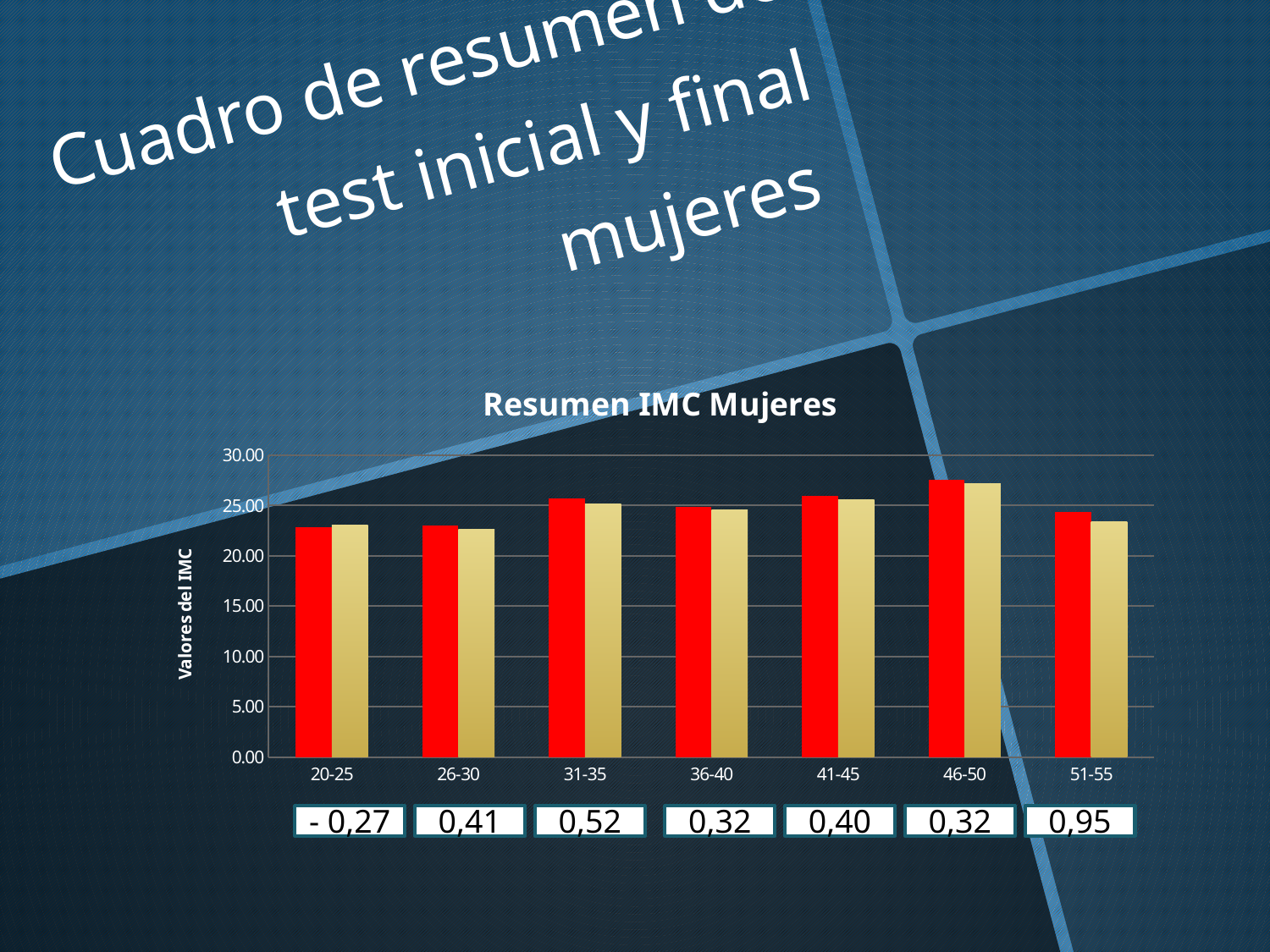
Is the red bar for the 46-50 age group greater or less than 25.00? greater What kind of chart is shown on the slide? bar chart How many bars are plotted for each age group in the chart? 2 Which red bar is taller, the one for 26-30 or the one for 46-50? 46-50 In the 51-55 age group, which bar is taller, the red one or the gold one? the red one How many age-group categories are shown on the x axis of the chart? 7 What is the title of the chart? Resumen IMC Mujeres Is the red bar for the 41-45 age group greater or less than 20.00? greater Is the gold bar for the 51-55 age group greater or less than 25.00? less What is the label on the vertical axis of the chart? Valores del IMC Which age group has the tallest red bar in the chart? 46-50